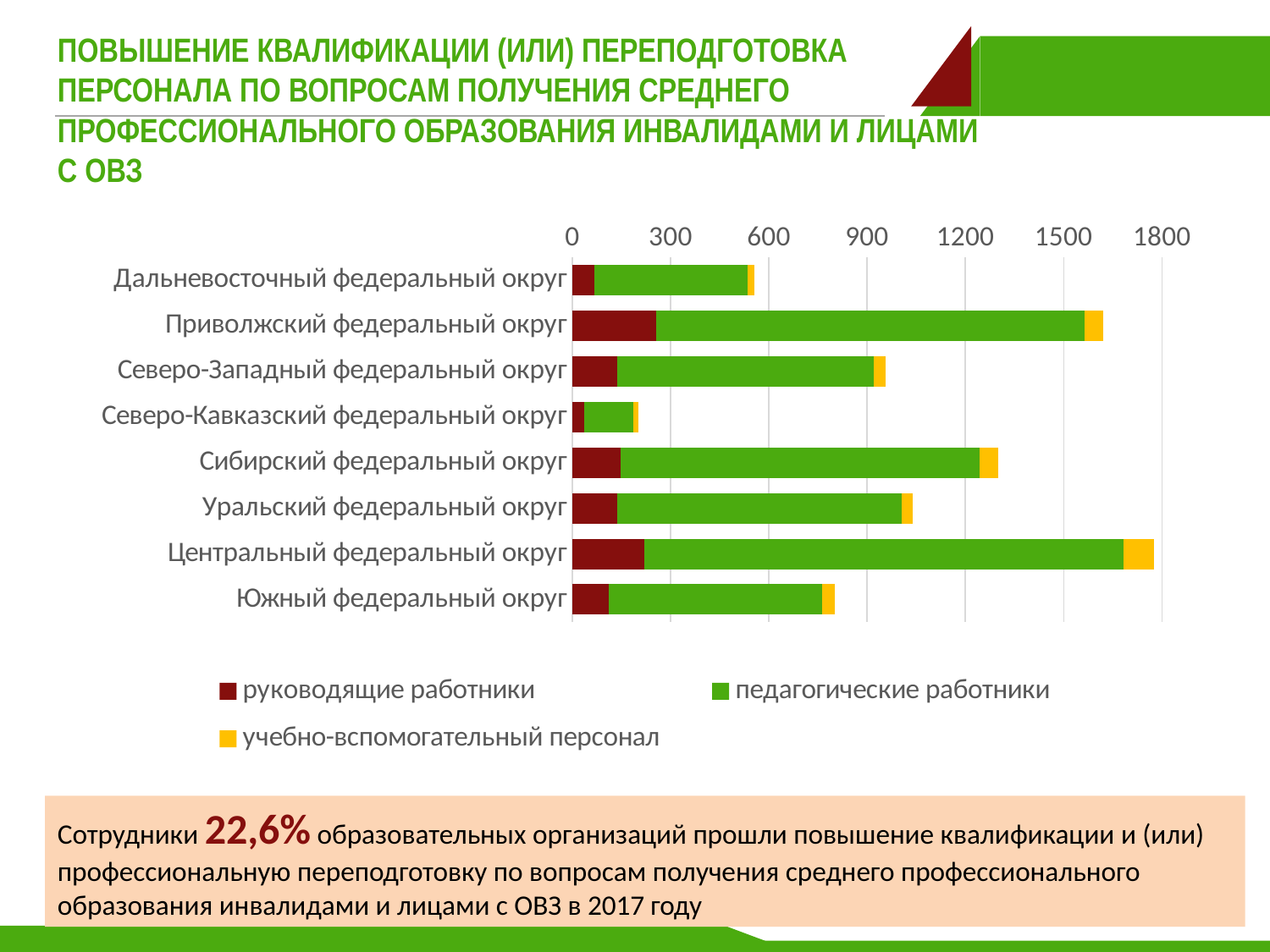
Is the total bar for Сибирский федеральный округ greater or less than 1200? greater Which federal district has the shortest total bar? Северо-Кавказский федеральный округ Which series is shown in dark red in the chart legend? руководящие работники Which federal district has the longest total bar? Центральный федеральный округ Is the total bar for Южный федеральный округ greater or less than 900? less Which has the longer total bar: Уральский федеральный округ or Южный федеральный округ? Уральский федеральный округ How many federal districts (categories) are shown in the chart? 8 Which has the longer total bar: Приволжский федеральный округ or Сибирский федеральный округ? Приволжский федеральный округ How many series does the chart legend list? 3 Is the total bar for Северо-Кавказский федеральный округ greater or less than 300? less What kind of chart is shown on the slide? bar chart